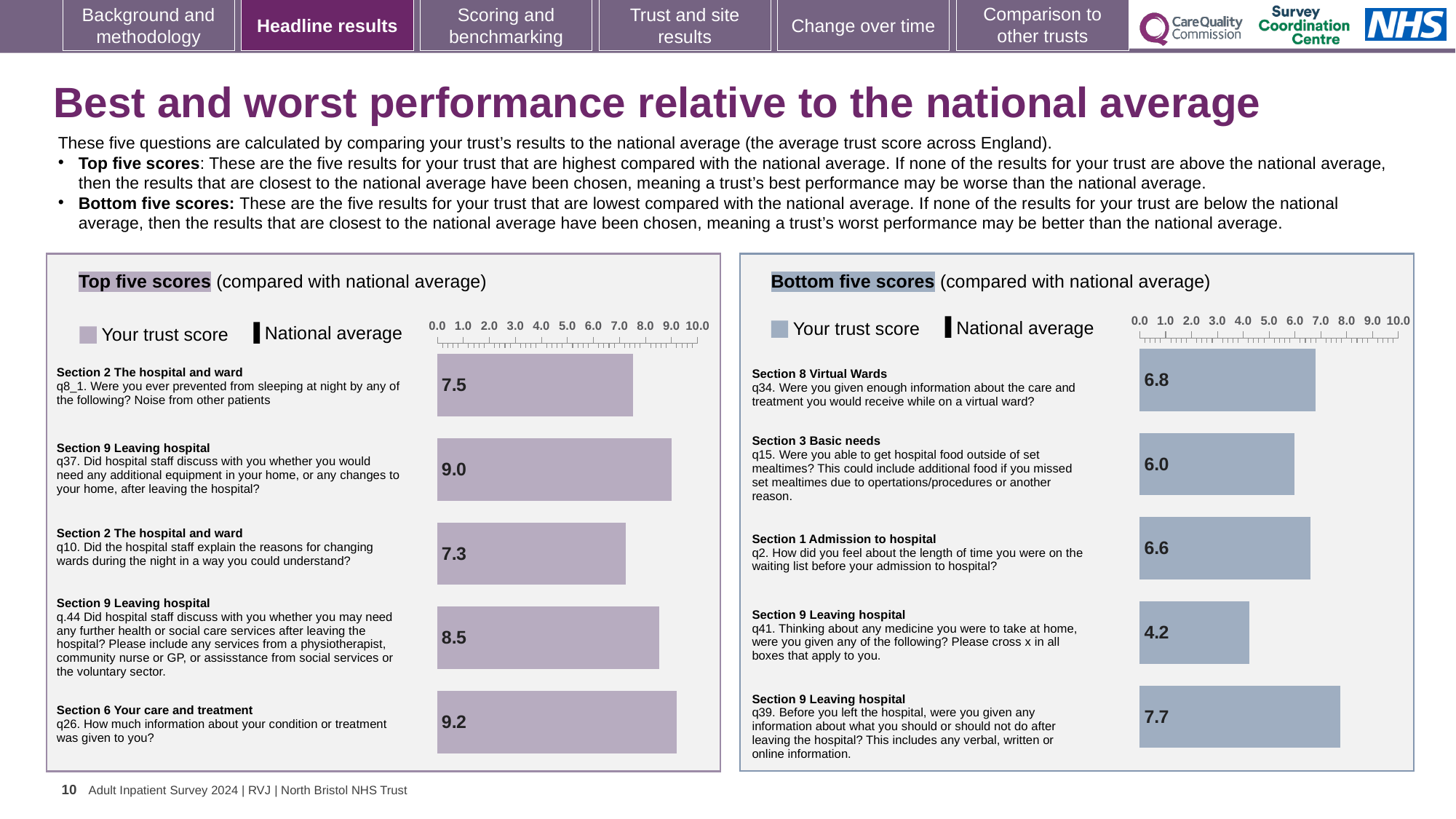
In the Top five scores chart, what is the trust score for q37 (Did hospital staff discuss with you whether you would need any additional equipment in your home)? 9.0 In the Bottom five scores chart, which question has the highest trust score? q39. Before you left the hospital, were you given any information about what you should or should not do after leaving the hospital? In the Bottom five scores chart, what is the trust score for q41 (Thinking about any medicine you were to take at home)? 4.2 In the Top five scores chart, what is the difference between the trust scores for q26 and q10? 1.9 In the Top five scores chart, which question has the highest trust score? q26. How much information about your condition or treatment was given to you? How many series does the legend of the Top five scores chart list? 2 How many questions are plotted in the Top five scores chart? 5 In the Bottom five scores chart, which has the larger trust score: q34 (virtual wards) or q2 (waiting list before admission)? q34 In the Bottom five scores chart, what is the difference between the trust scores for q39 and q15? 1.7 In the Top five scores chart, what is the trust score for q8_1 (Were you ever prevented from sleeping at night by noise from other patients)? 7.5 What type of chart is used in the Bottom five scores panel? Bar chart In the Bottom five scores chart, which question has the lowest trust score? q41. Thinking about any medicine you were to take at home